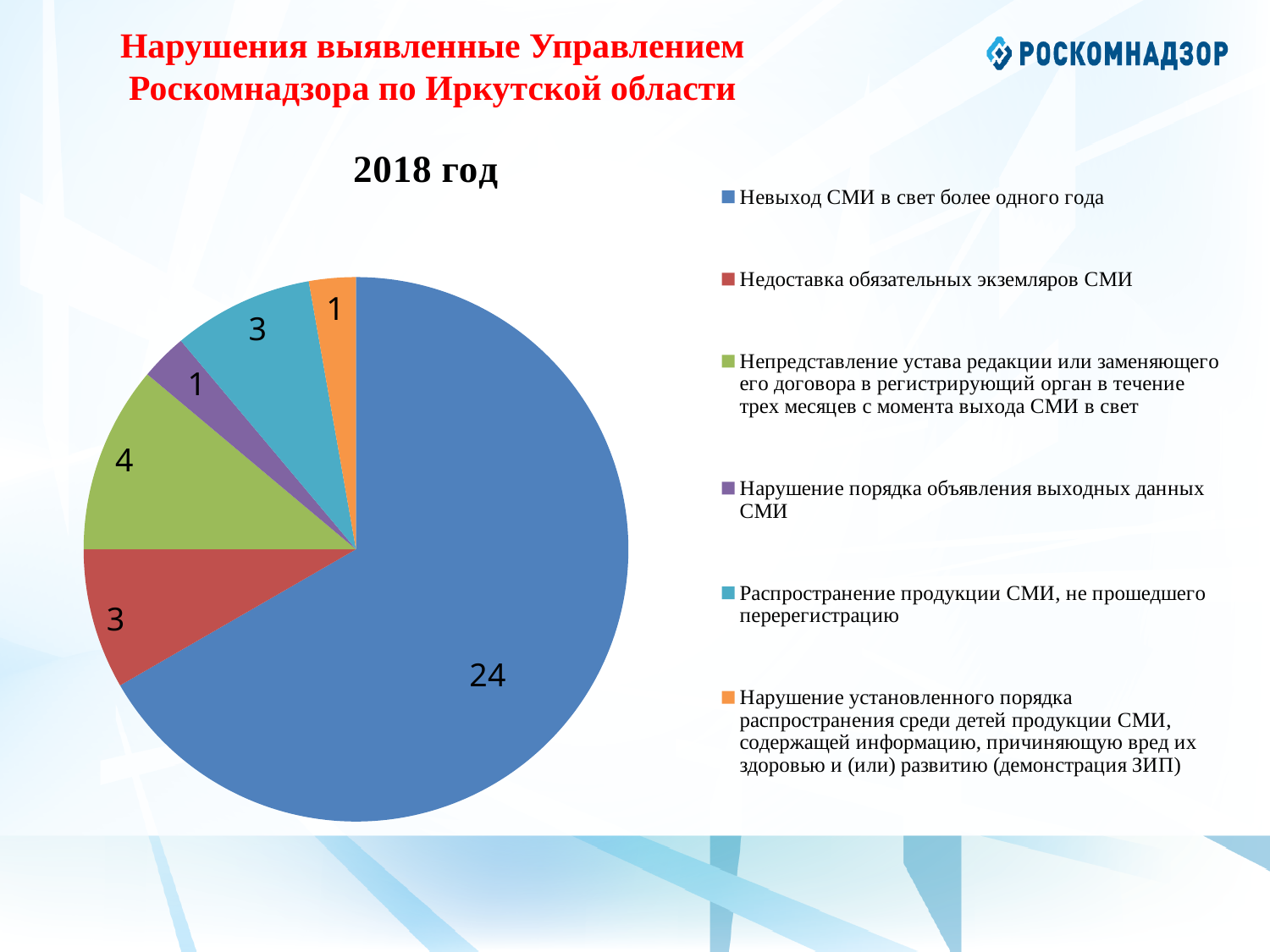
What is the title of the chart? 2018 год What is the value for 'Невыход СМИ в свет более одного года'? 24 Which category has the largest slice of the pie? Невыход СМИ в свет более одного года What colour is the slice for 'Нарушение установленного порядка распространения среди детей продукции СМИ...' (демонстрация ЗИП)? orange What is the value for 'Непредставление устава редакции или заменяющего его договора в регистрирующий орган в течение трех месяцев с момента выхода СМИ в свет'? 4 Which is larger: the value for 'Непредставление устава редакции...' or the value for 'Недоставка обязательных экземпляров СМИ'? Непредставление устава редакции... What is the value for 'Распространение продукции СМИ, не прошедшего перерегистрацию'? 3 What is the value for 'Нарушение порядка объявления выходных данных СМИ'? 1 What is the value for 'Недоставка обязательных экземпляров СМИ'? 3 What is the difference between the value for 'Невыход СМИ в свет более одного года' and the value for 'Непредставление устава редакции или заменяющего его договора в регистрирующий орган в течение трех месяцев с момента выхода СМИ в свет'? 20 What type of chart is shown on the slide? pie chart How many slices does the pie chart have? 6